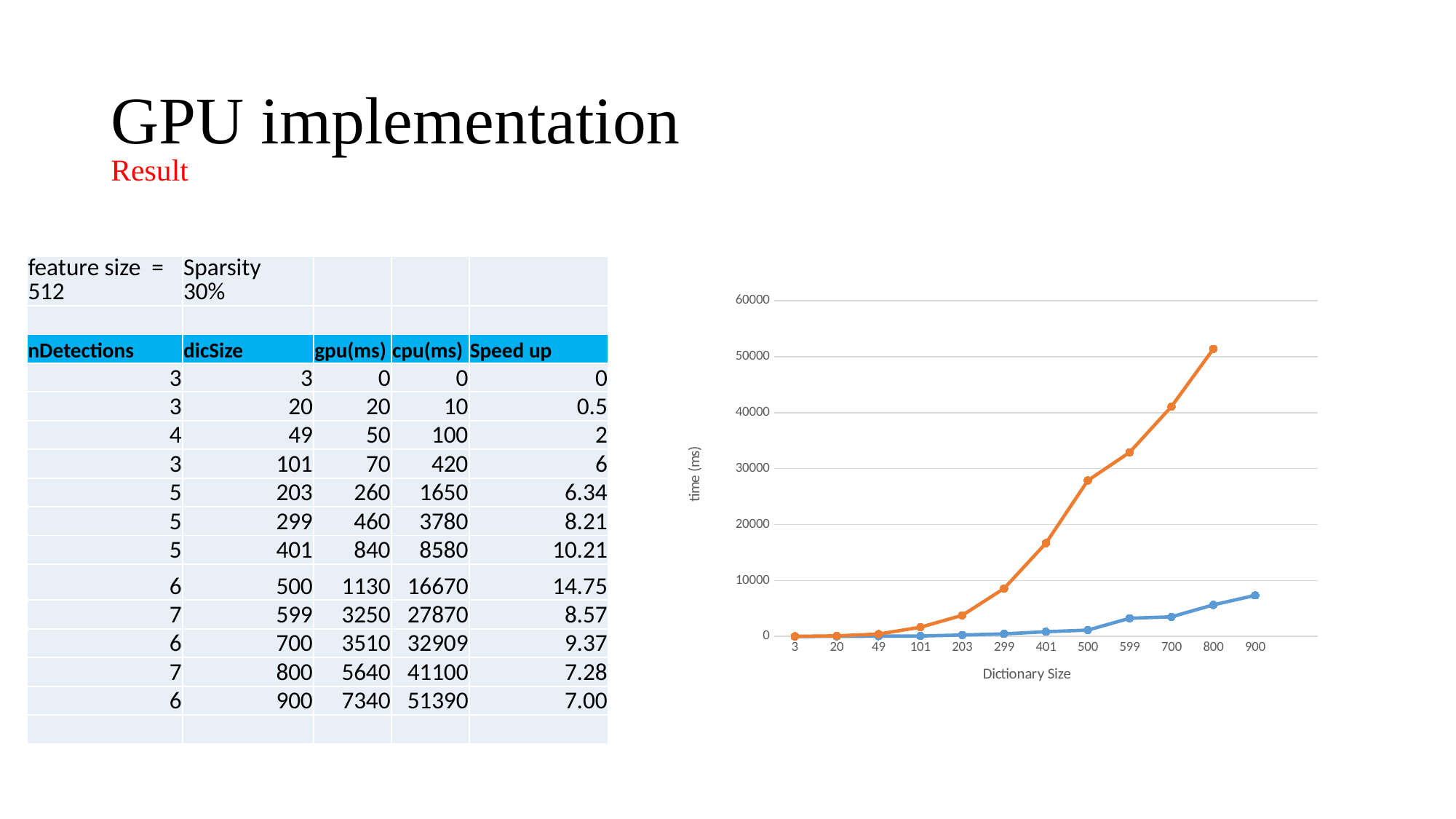
How many lines are plotted in the line chart? 2 In the line chart, is the value of the orange line at dictionary size 401 greater or less than 10000? greater In the line chart, is the value of the orange line at dictionary size 500 greater or less than 20000? greater What is the x-axis title of the line chart? Dictionary Size At which dictionary size does the orange line in the line chart reach its highest value? 800 In the line chart, is the value of the blue line at dictionary size 900 greater or less than 10000? less What type of chart is shown on the right of the slide? line chart How many points are plotted along the x axis of the line chart? 12 What is the y-axis title of the line chart? time (ms) Do the values of the orange line in the line chart rise or fall as dictionary size increases? rise